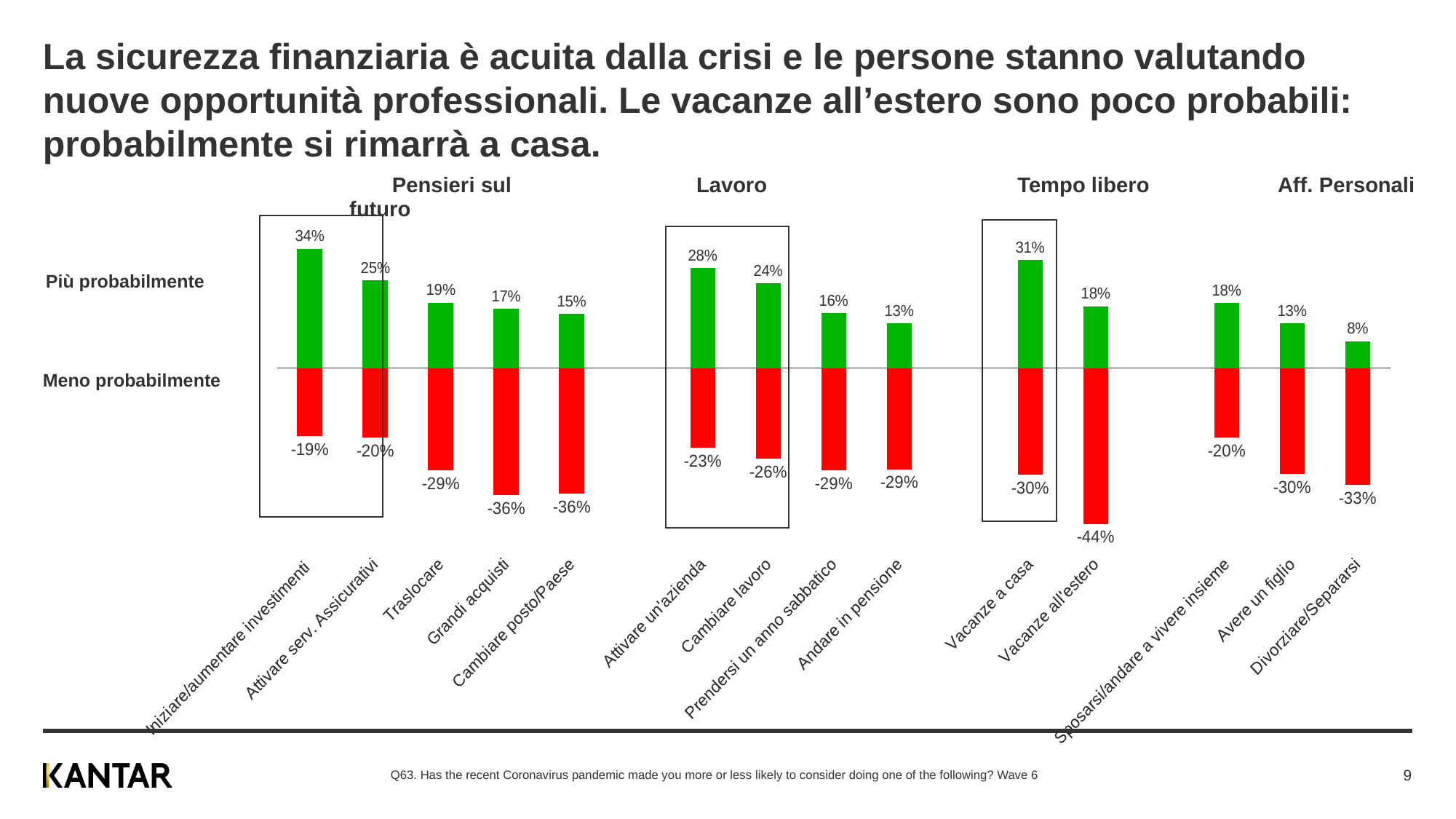
Which category has the lowest 'Più probabilmente' value? Divorziare/Separarsi What type of chart is shown on the slide? Bar chart Which category has the highest 'Più probabilmente' value? Iniziare/aumentare investimenti What is the 'Più probabilmente' value for Cambiare lavoro? 24% What is the 'Più probabilmente' value for Iniziare/aumentare investimenti? 34% How many categories are shown on the x axis of the chart? 14 Which category has the largest negative 'Meno probabilmente' value? Vacanze all'estero What is the difference between the 'Più probabilmente' values for Vacanze a casa and Vacanze all'estero? 13% What is the 'Meno probabilmente' value for Divorziare/Separarsi? -33% What is the 'Meno probabilmente' value for Vacanze all'estero? -44% Which has a higher 'Più probabilmente' value, Attivare un'azienda or Traslocare? Attivare un'azienda Which colour represents the 'Meno probabilmente' values in the chart? Red